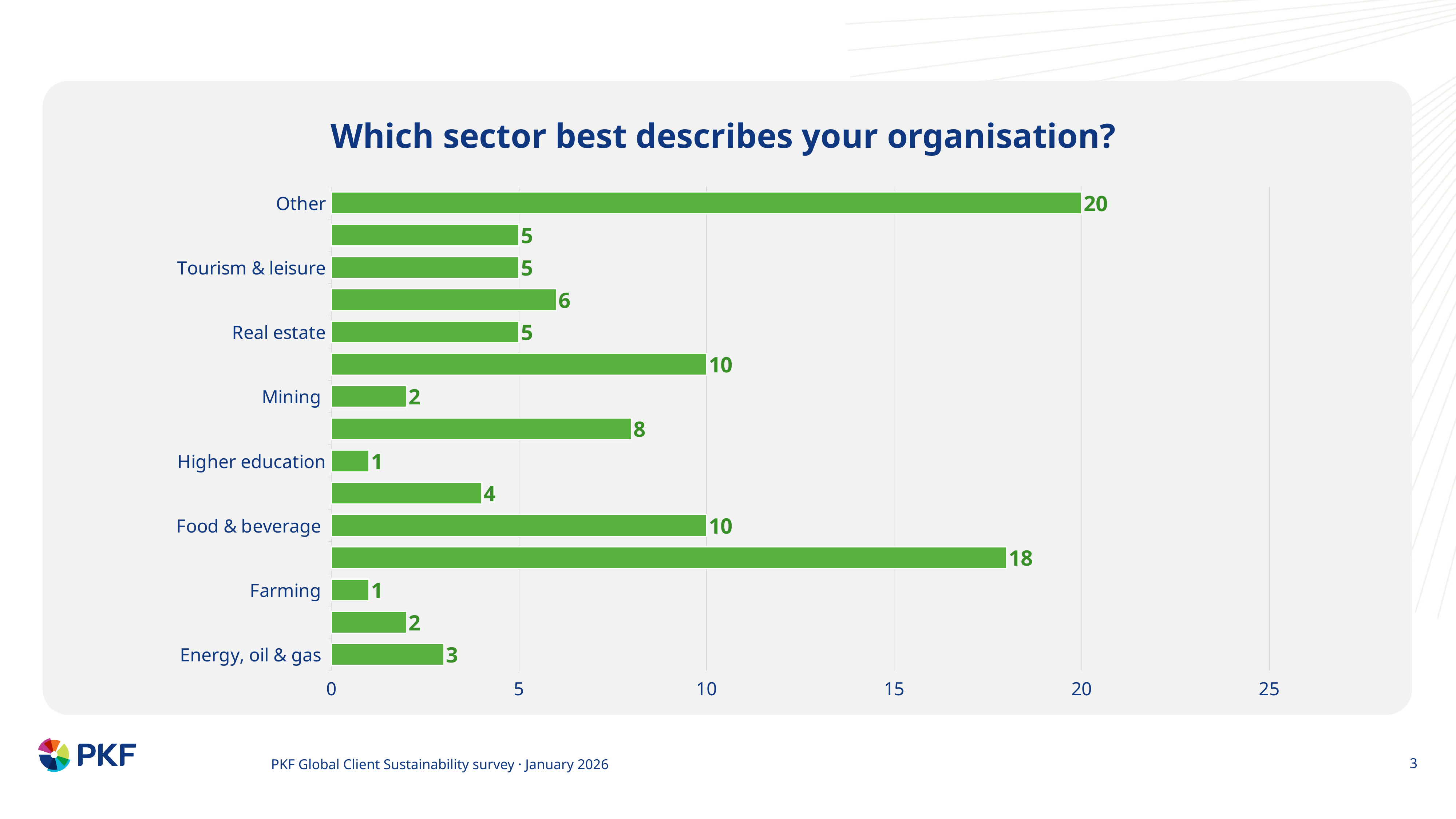
Which is larger, the value for Real estate or the value for Energy, oil & gas? Real estate What is the value for Energy, oil & gas? 3 What is the difference between the values for Other and Food & beverage? 10 What is the value for Other? 20 What is the value for Mining? 2 Is the value for Tourism & leisure greater or less than 10? less What is the value for Higher education? 1 What is the value for Food & beverage? 10 What kind of chart is shown on the slide? bar chart What is the difference between the values for Tourism & leisure and Mining? 3 How many bars are plotted in the chart? 15 Which labelled sector has the highest value? Other